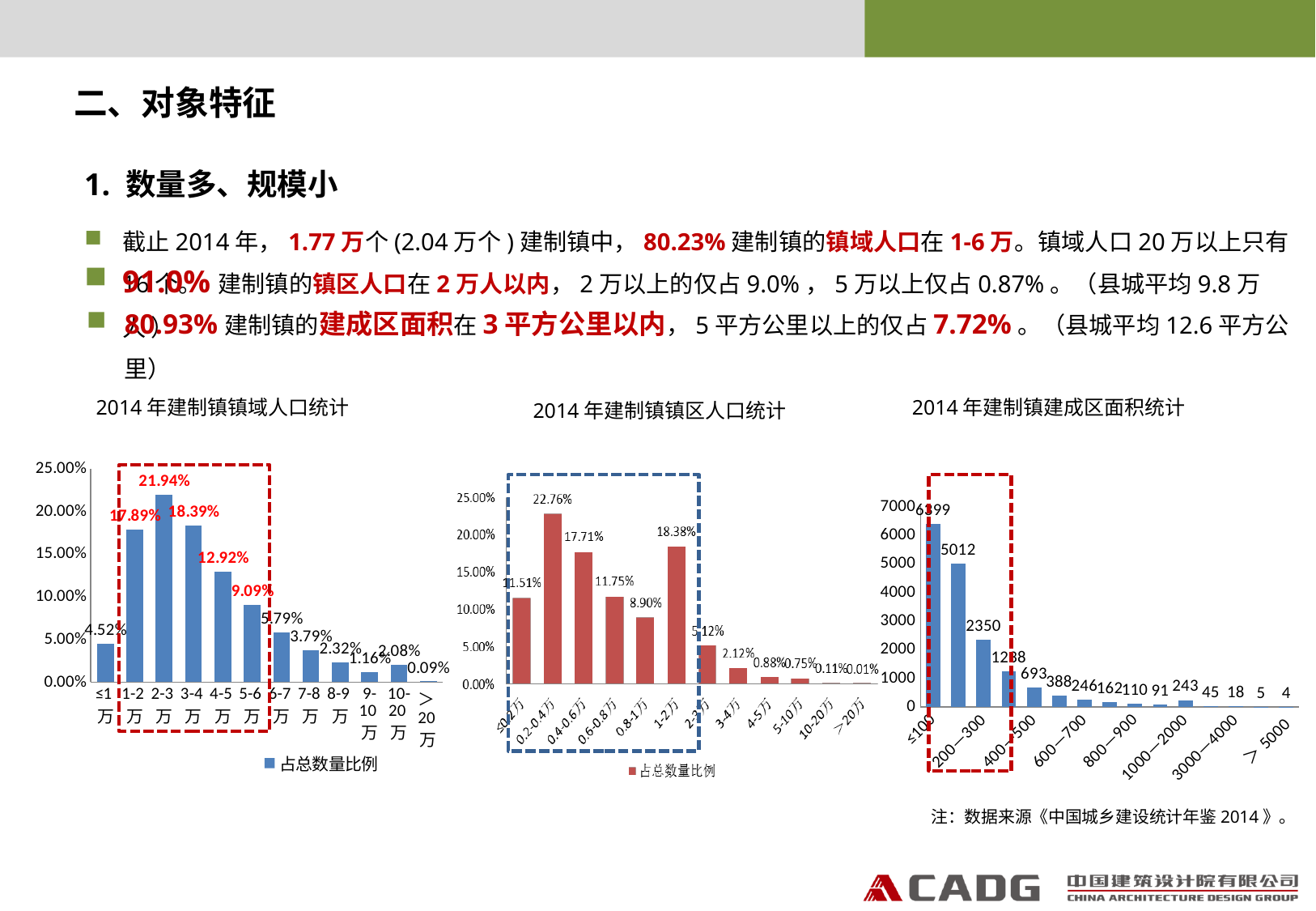
In the chart titled 2014年建制镇镇域人口统计, which category has the lowest value? >20万 In the chart titled 2014年建制镇镇区人口统计, what is the value for the 1-2万 category? 18.38% In the chart titled 2014年建制镇镇区人口统计, which is larger, the value for 0.4-0.6万 or the value for 1-2万? 1-2万 In the chart titled 2014年建制镇镇域人口统计, which category has the highest value? 2-3万 In the chart titled 2014年建制镇镇区人口统计, which category has the highest value? 0.2-0.4万 In the chart titled 2014年建制镇镇域人口统计, how many categories are shown on the x axis? 12 In the chart titled 2014年建制镇镇域人口统计, what is the legend entry? 占总数量比例 In the chart titled 2014年建制镇镇域人口统计, what is the value for the 2-3万 category? 21.94% In the chart titled 2014年建制镇镇区人口统计, what kind of chart is this? bar chart In the chart titled 2014年建制镇建成区面积统计, what is the value for the ≤100 category? 6399 In the chart titled 2014年建制镇镇域人口统计, what is the difference between the values for 1-2万 and 5-6万? 8.80% In the chart titled 2014年建制镇建成区面积统计, what is the value for the 1000—2000 category? 243